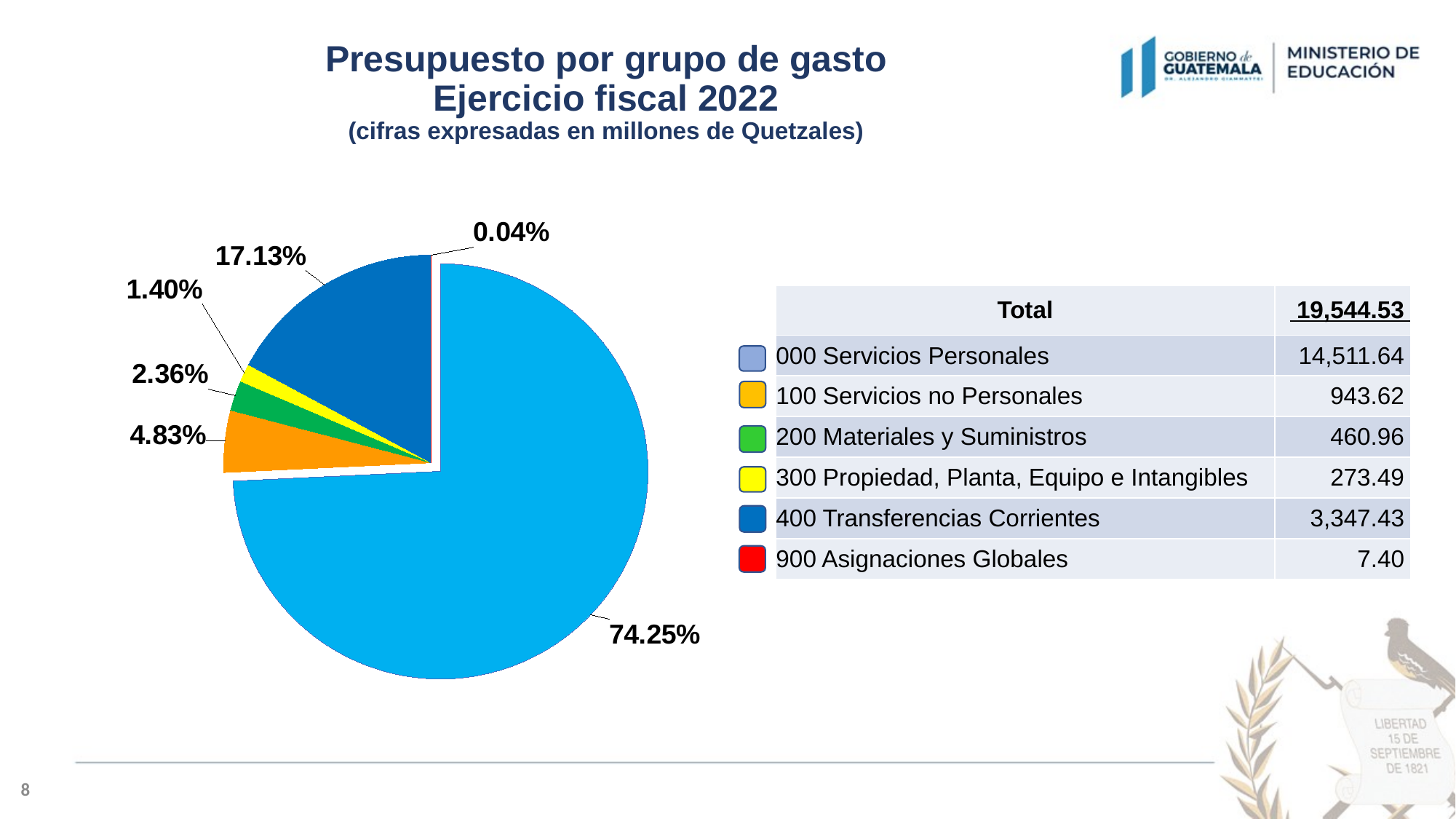
What share of the pie does 400 Transferencias Corrientes represent? 17.13% What is the total shown in the table? 19,544.53 How many slices does the pie chart have? 6 What share of the pie does 300 Propiedad, Planta, Equipo e Intangibles represent? 1.40% What is the difference in percentage points between the 400 Transferencias Corrientes slice and the 100 Servicios no Personales slice? 12.30 What type of chart is shown on the slide? pie chart What share of the pie does 100 Servicios no Personales represent? 4.83% Which expense group has the smallest slice of the pie? 900 Asignaciones Globales Which is larger, the slice for 200 Materiales y Suministros or the slice for 300 Propiedad, Planta, Equipo e Intangibles? 200 Materiales y Suministros Which expense group has the largest slice of the pie? 000 Servicios Personales What is the value shown for 200 Materiales y Suministros in the table? 460.96